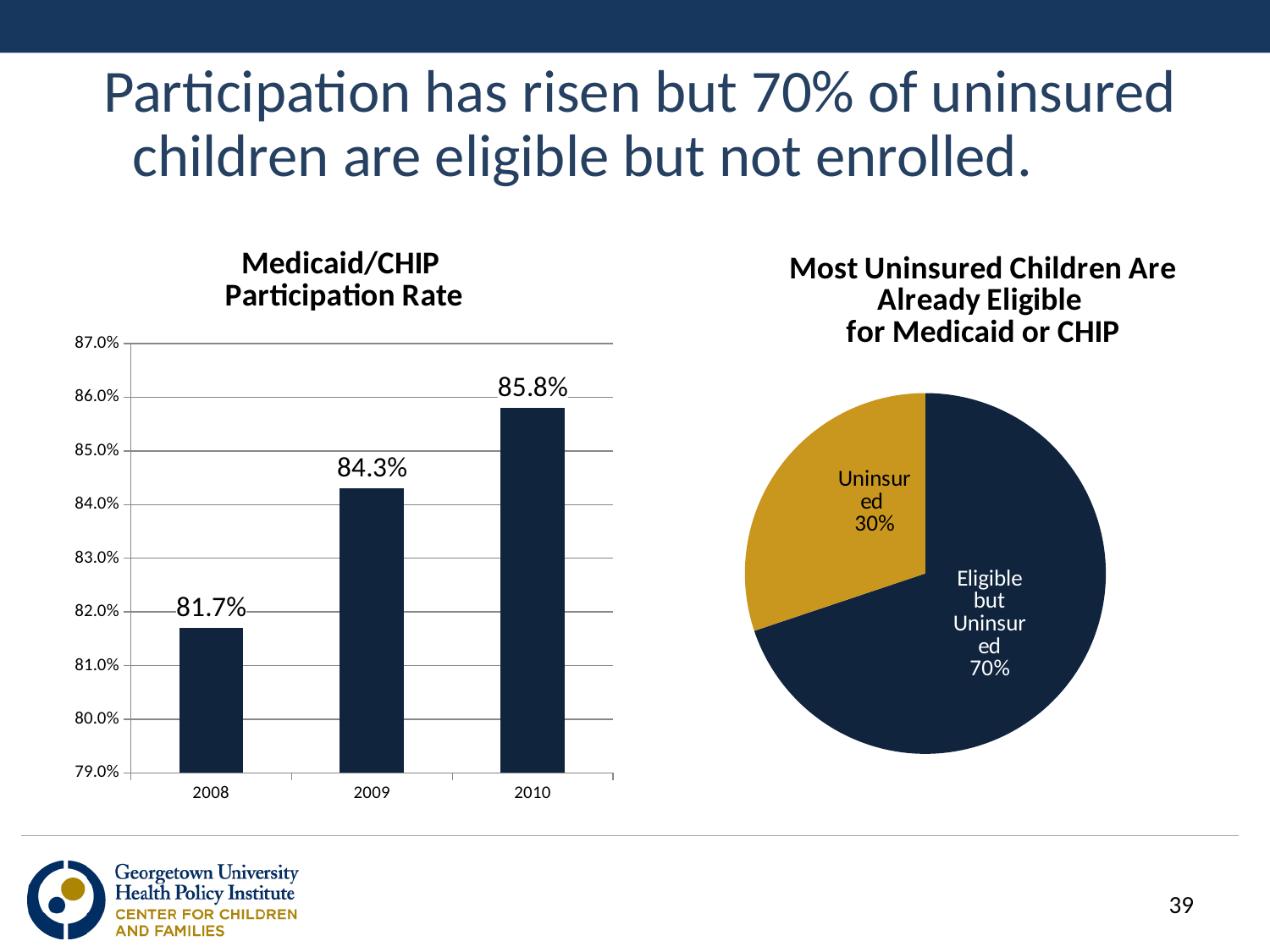
In the Medicaid/CHIP Participation Rate chart, what is the participation rate for 2009? 84.3% In the Medicaid/CHIP Participation Rate chart, what is the difference between the 2010 and 2008 participation rates? 4.1% In the Medicaid/CHIP Participation Rate chart, how many years are shown? 3 In the Medicaid/CHIP Participation Rate chart, which year has the lowest participation rate? 2008 In the Medicaid/CHIP Participation Rate chart, what is the participation rate for 2010? 85.8% In the Medicaid/CHIP Participation Rate chart, does the participation rate rise or fall from 2008 to 2010? rise In the Medicaid/CHIP Participation Rate chart, is the participation rate for 2008 greater or less than 82.0%? less What kind of chart is the chart on the right side of the slide? pie chart In the Medicaid/CHIP Participation Rate chart, which year has the highest participation rate? 2010 What kind of chart is the Medicaid/CHIP Participation Rate chart? bar chart In the Most Uninsured Children Are Already Eligible for Medicaid or CHIP chart, what share of the pie is Eligible but Uninsured? 70% In the Most Uninsured Children Are Already Eligible for Medicaid or CHIP chart, which slice is larger, Uninsured or Eligible but Uninsured? Eligible but Uninsured